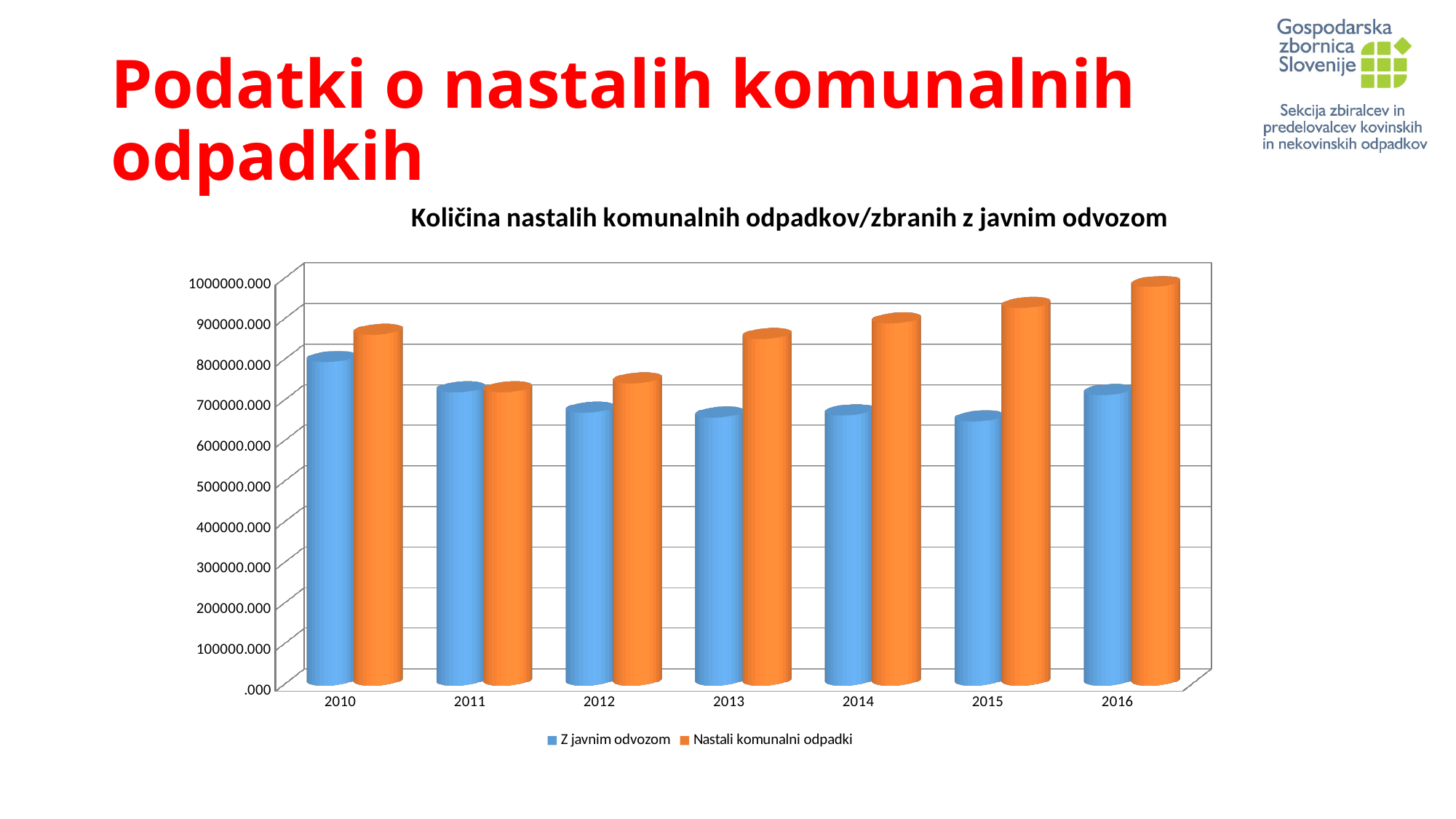
How many years are shown on the x axis? 7 Which colour represents the series 'Nastali komunalni odpadki'? orange What is the title of the chart? Količina nastalih komunalnih odpadkov/zbranih z javnim odvozom Is the value for 'Z javnim odvozom' in 2015 greater or less than 700000.000? less In which year is the value for 'Z javnim odvozom' highest? 2010 What kind of chart is shown on the slide? bar chart Is the value for 'Nastali komunalni odpadki' in 2012 greater or less than 800000.000? less Do the values for 'Nastali komunalni odpadki' rise or fall from 2012 to 2016? rise How many series does the legend list? 2 In 2016, which series has the larger value, 'Z javnim odvozom' or 'Nastali komunalni odpadki'? Nastali komunalni odpadki Is the value for 'Nastali komunalni odpadki' in 2016 greater or less than 900000.000? greater In which year is the value for 'Nastali komunalni odpadki' highest? 2016